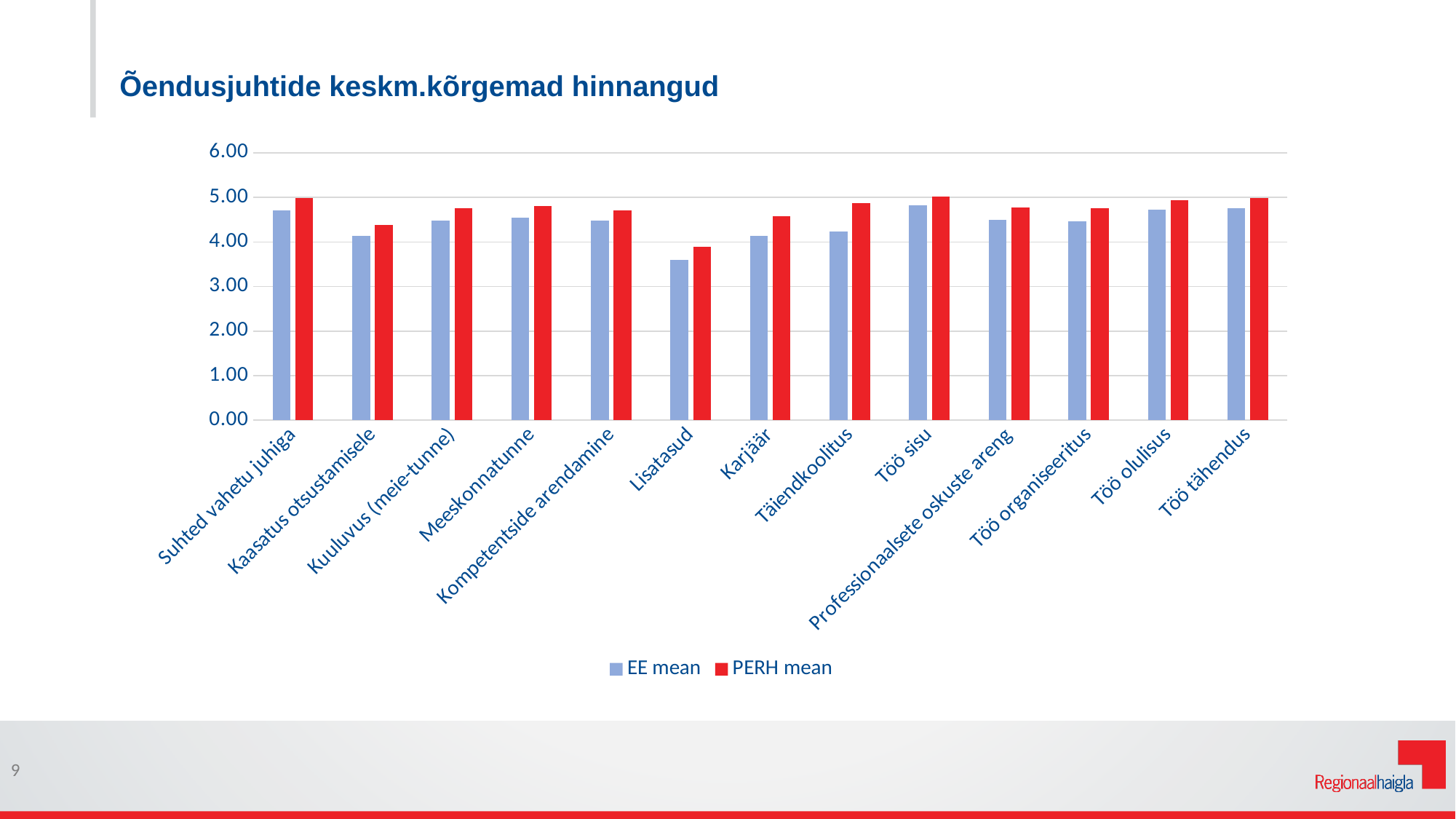
Which category has the lowest EE mean value? Lisatasud Is the PERH mean value for Karjäär greater or less than 5.00? less What kind of chart is shown on the slide? bar chart Which is larger: the EE mean for Lisatasud or the EE mean for Karjäär? Karjäär Which category has the lowest PERH mean value? Lisatasud Is the EE mean value for Töö sisu greater or less than 4.00? greater Which colour represents the PERH mean series in the chart? red How many series does the legend list? 2 Is the EE mean value for Lisatasud greater or less than 4.00? less For Täiendkoolitus, which series has the larger value, EE mean or PERH mean? PERH mean What is the title of the chart on the slide? Õendusjuhtide keskm.kõrgemad hinnangud How many categories are shown on the x axis of the chart? 13